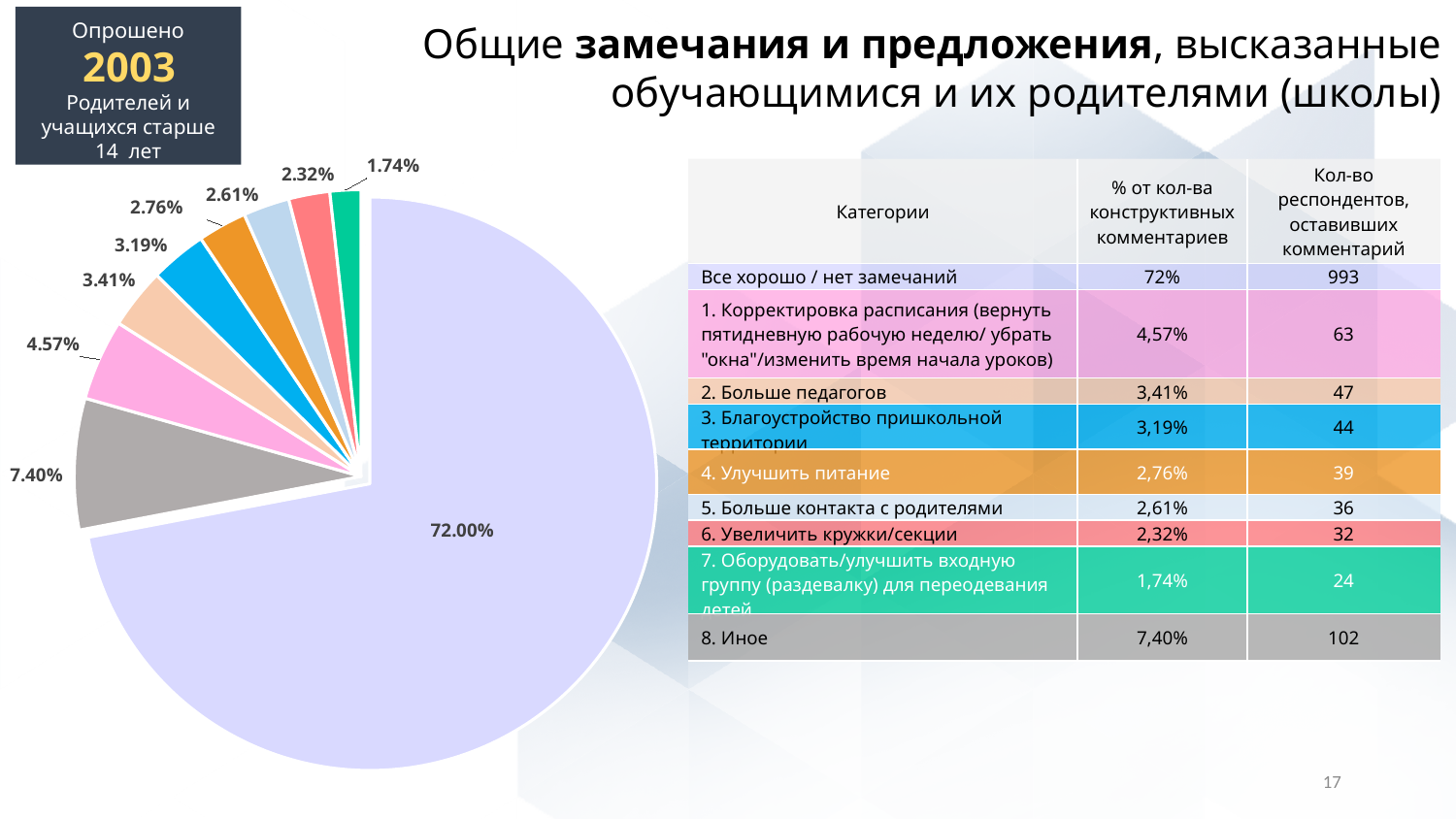
What value is labelled on the pink slice of the pie chart? 4.57% What value is labelled on the grey slice of the pie chart? 7.40% How many slices does the pie chart have? 9 According to the table on the slide, which category does the 72.00% slice of the pie chart correspond to? Все хорошо / нет замечаний What share of the pie does the light purple slice take? 72.00% What is the value of the largest slice in the pie chart? 72.00% What kind of chart is shown on the left of the slide? pie chart What is the value of the smallest slice in the pie chart? 1.74% What is the difference between the 2.61% slice and the 2.32% slice in the pie chart? 0.29 percentage points What value is labelled on the green slice of the pie chart? 1.74% What is the difference between the grey slice (7.40%) and the pink slice (4.57%) in the pie chart? 2.83 percentage points Which slice is larger in the pie chart: the blue slice (3.19%) or the orange slice (2.76%)? the blue slice (3.19%)